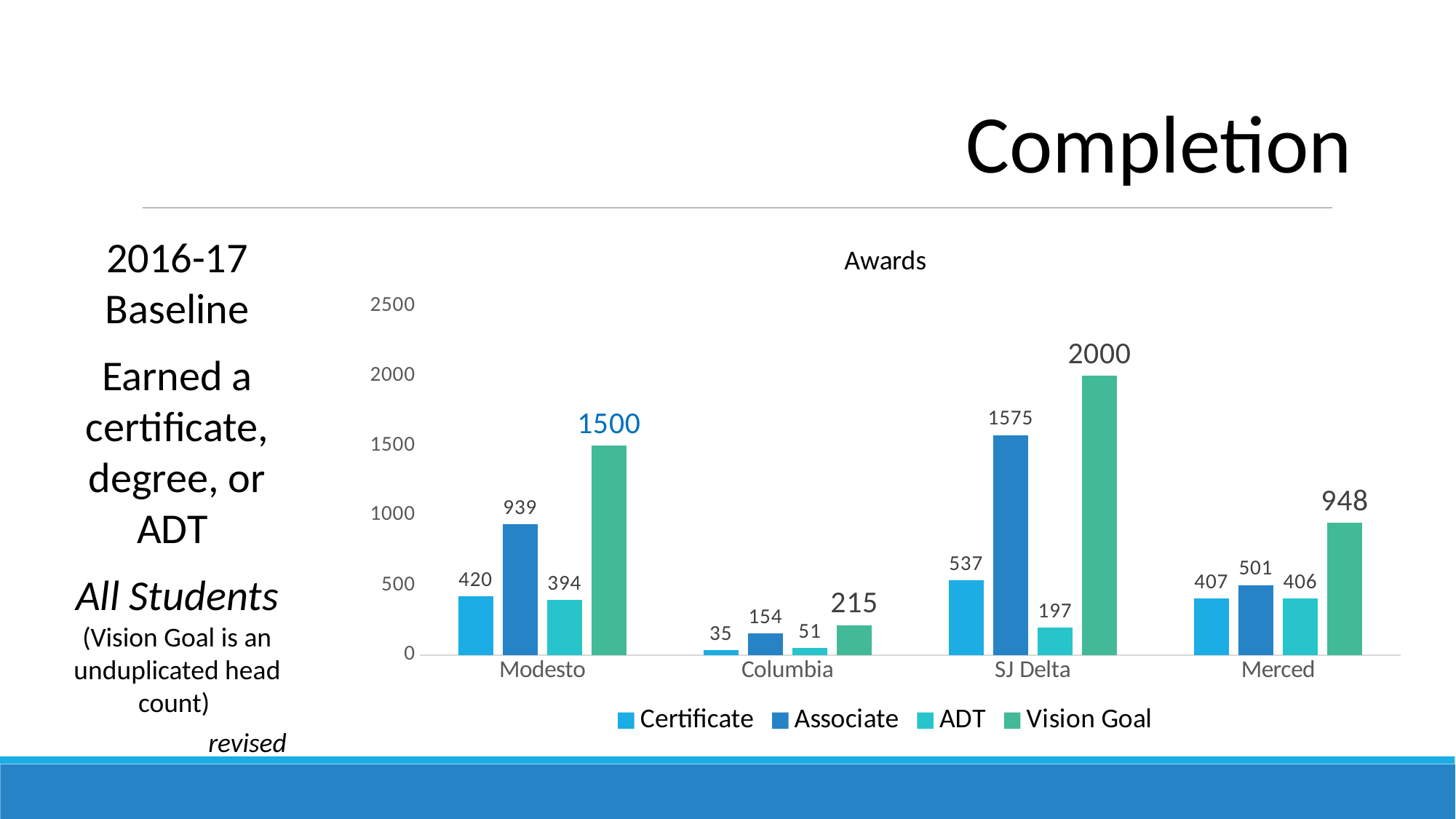
Which is larger, the Certificate value for Modesto or the Certificate value for SJ Delta? SJ Delta What is the title of the chart? Awards What is the Vision Goal value for SJ Delta? 2000 What is the ADT value for Columbia? 51 How many colleges are shown on the x axis? 4 What is the Certificate value for Merced? 407 What kind of chart is shown? Bar chart How many series does the legend list? 4 What is the Associate value for Modesto? 939 What is the difference between the Vision Goal and the Associate value for SJ Delta? 425 Which college has the lowest Vision Goal value? Columbia Which college has the highest Associate value? SJ Delta